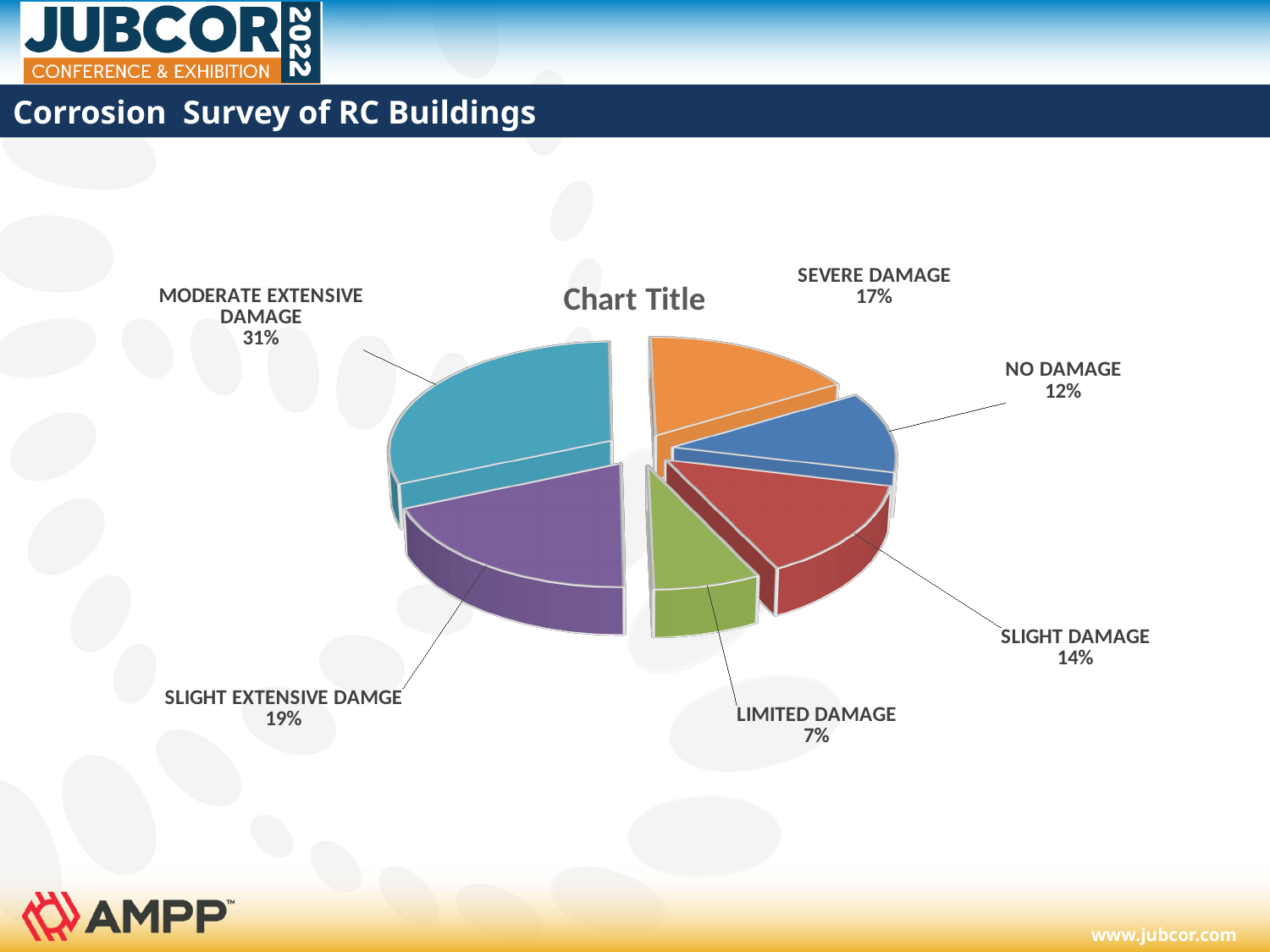
What percentage of the pie is labelled MODERATE EXTENSIVE DAMAGE? 31% What kind of chart is shown on the slide? Pie chart What is the title shown on the chart? Chart Title Which category has the largest share of the pie? MODERATE EXTENSIVE DAMAGE How many slices does the pie chart have? 6 Which is larger, the share for SEVERE DAMAGE or the share for NO DAMAGE? SEVERE DAMAGE Which category has the smallest share of the pie? LIMITED DAMAGE What percentage of the pie is labelled NO DAMAGE? 12% What colour is the slice for MODERATE EXTENSIVE DAMAGE? Teal (light blue) What percentage of the pie is labelled LIMITED DAMAGE? 7% What percentage of the pie is labelled SEVERE DAMAGE? 17% What is the difference in percentage points between SLIGHT EXTENSIVE DAMGE and SLIGHT DAMAGE? 5